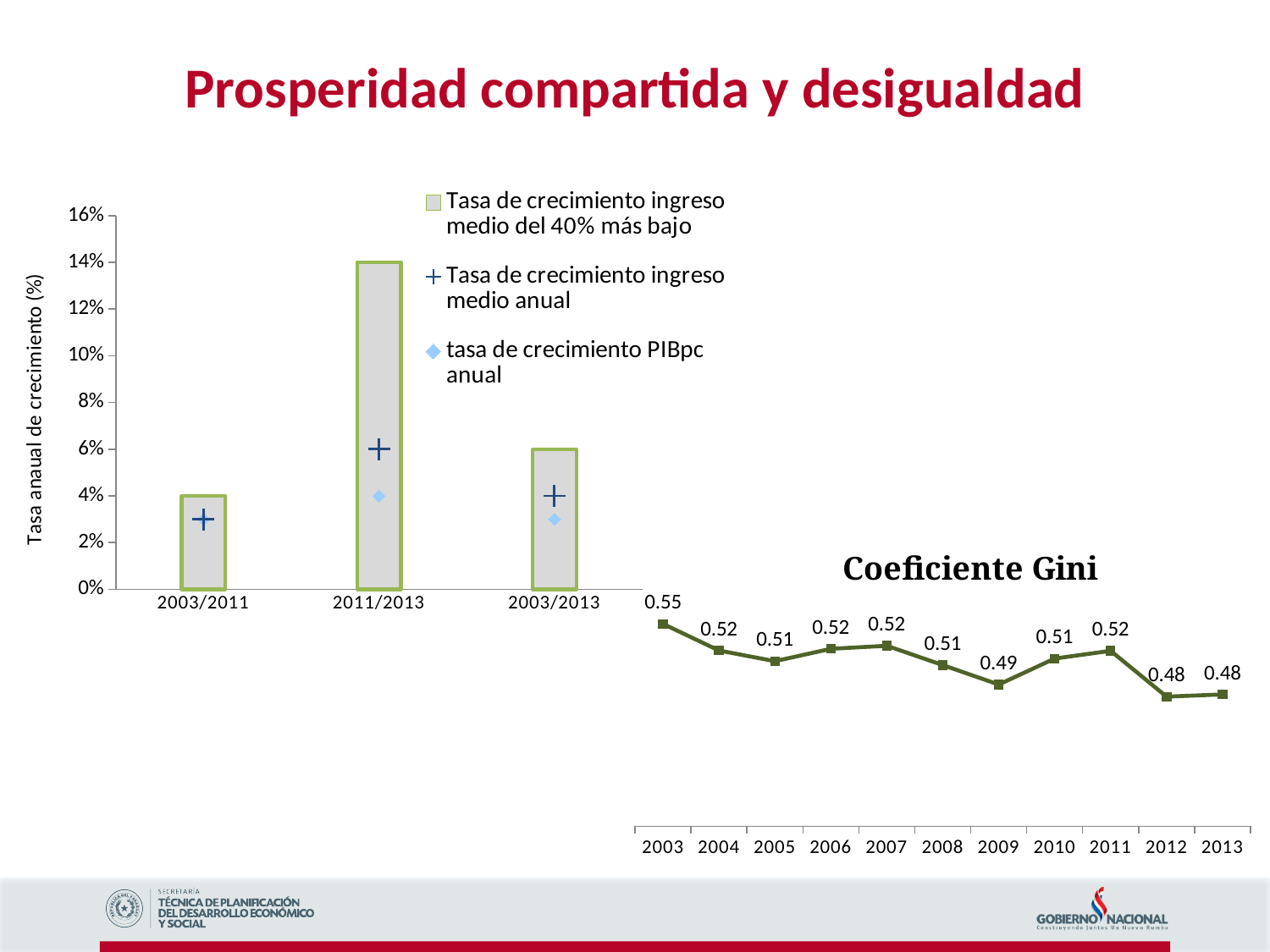
In the 'Coeficiente Gini' chart, which year has the highest value? 2003 In the left bar chart, which period has the highest bar? 2011/2013 In the left bar chart, what is the value of the bar for 2003/2011? 4% In the left bar chart, is the 'Tasa de crecimiento ingreso medio anual' marker for 2003/2011 greater or less than 4%? less What kind of chart is the 'Coeficiente Gini' chart? line chart In the left bar chart, how many periods are shown on the x axis? 3 In the left bar chart, which period has the lowest bar? 2003/2011 In the 'Coeficiente Gini' chart, what is the value for 2003? 0.55 In the 'Coeficiente Gini' chart, what is the difference between the values for 2003 and 2013? 0.07 In the left bar chart, how many series does the legend list? 3 In the left bar chart, what is the value of the bar for 2011/2013? 14% In the 'Coeficiente Gini' chart, what is the value for 2009? 0.49